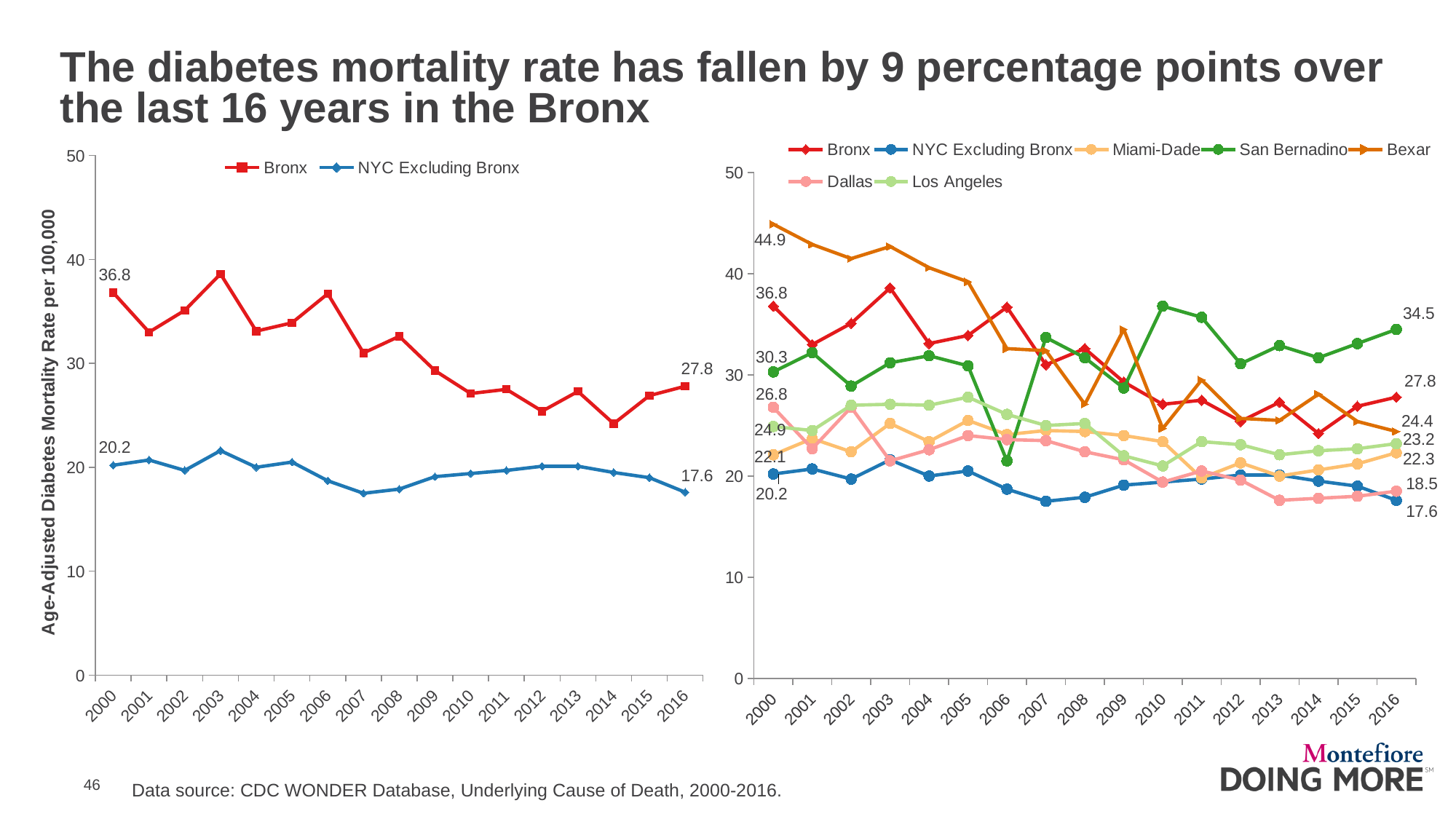
In the right chart, what is the difference between the Dallas rate in 2000 and in 2016? 8.3 In the left chart, what kind of chart is shown? Line chart In the right chart, which series had the lowest rate in 2000? NYC Excluding Bronx In the left chart, how many series does the legend list? 2 In the left chart, what was the Bronx diabetes mortality rate in 2016? 27.8 In the right chart, what was the Bexar rate in 2000? 44.9 In the right chart, how many series does the legend list? 7 In the left chart, what was the NYC Excluding Bronx rate in 2016? 17.6 In the left chart, by how much did the Bronx rate fall between 2000 and 2016? 9 In the right chart, what was the San Bernadino rate in 2016? 34.5 In the left chart, what was the Bronx diabetes mortality rate in 2000? 36.8 In the right chart, which series had the highest rate in 2016? San Bernadino